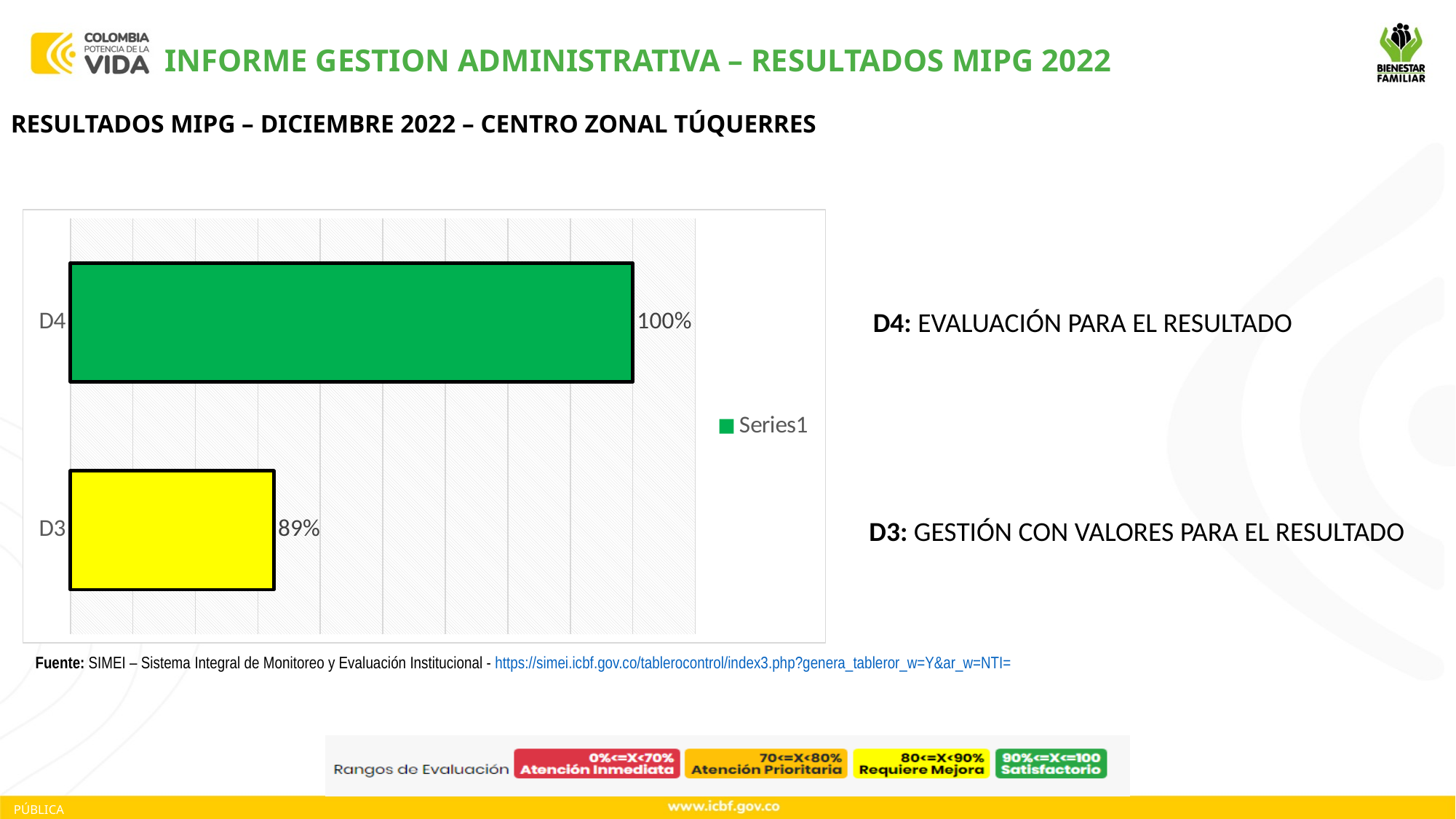
How many series does the legend list? 1 What is the difference between the values for D4 and D3? 11% Which category has the lowest value? D3 What kind of chart is shown on the slide? Bar chart Which is larger, the value for D4 or the value for D3? D4 How many categories are shown in the chart? 2 What is the value for D3? 89% What is the value for D4? 100% Which category has the highest value? D4 What is the name of the series listed in the legend? Series1 What colour is the bar for D3? Yellow